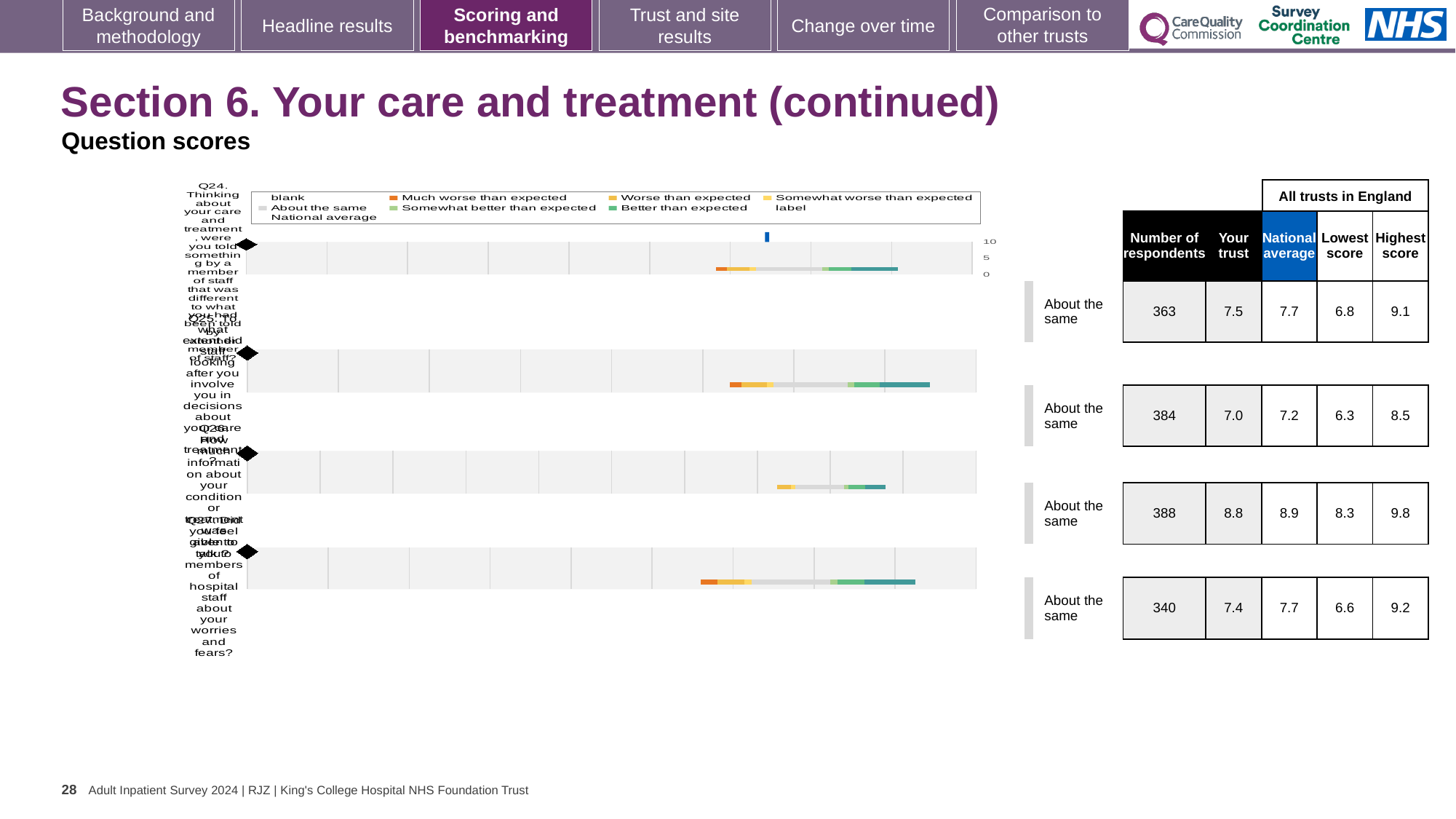
Which question has the lowest 'Your trust' score? Q25 What is the 'Your trust' score for Q25? 7.0 What benchmark category is shown for all four questions on this slide? About the same What is the highest score among all trusts in England for Q26? 9.8 What is the lowest score among all trusts in England for Q25? 6.3 Which question has the highest 'Your trust' score? Q26 How many respondents answered Q27? 340 What is the difference between the national average and the 'Your trust' score for Q26? 0.1 What is the 'Your trust' score for Q24? 7.5 How many survey questions (rows) are plotted in the chart? 4 What kind of chart is used to show the question scores? bar chart For Q24, which is larger: the 'Your trust' score or the national average? National average